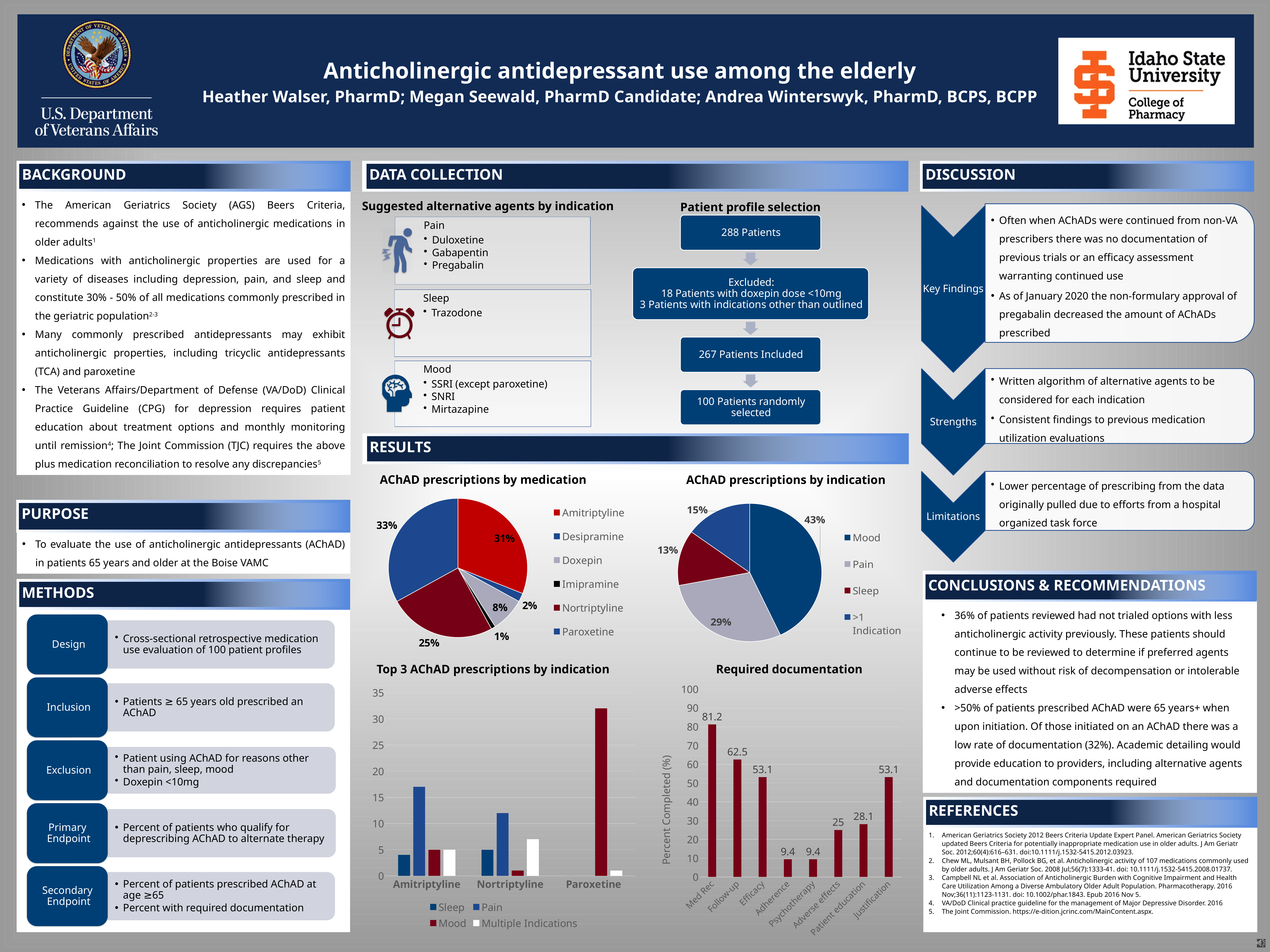
In the 'AChAD prescriptions by medication' pie chart, which medication has the smallest share? Imipramine In the 'Required documentation' chart, what is the value for Med Rec? 81.2 How many series does the legend of the 'Top 3 AChAD prescriptions by indication' chart list? 4 In the 'Required documentation' chart, what is the difference between Follow-up and Patient education? 34.4 How many categories are shown on the x axis of the 'Required documentation' chart? 8 In the 'AChAD prescriptions by medication' pie chart, what share of prescriptions is Paroxetine? 33% In the 'Top 3 AChAD prescriptions by indication' chart, is the Mood value for Paroxetine greater or less than 30? greater How many entries does the legend of the 'AChAD prescriptions by medication' pie chart list? 6 In the 'Top 3 AChAD prescriptions by indication' chart, which series is larger for Amitriptyline: Pain or Sleep? Pain In the 'AChAD prescriptions by indication' pie chart, what share is Mood? 43% What kind of chart is 'AChAD prescriptions by indication'? Pie chart In the 'AChAD prescriptions by indication' pie chart, what is the difference between the Pain share and the Sleep share? 16%